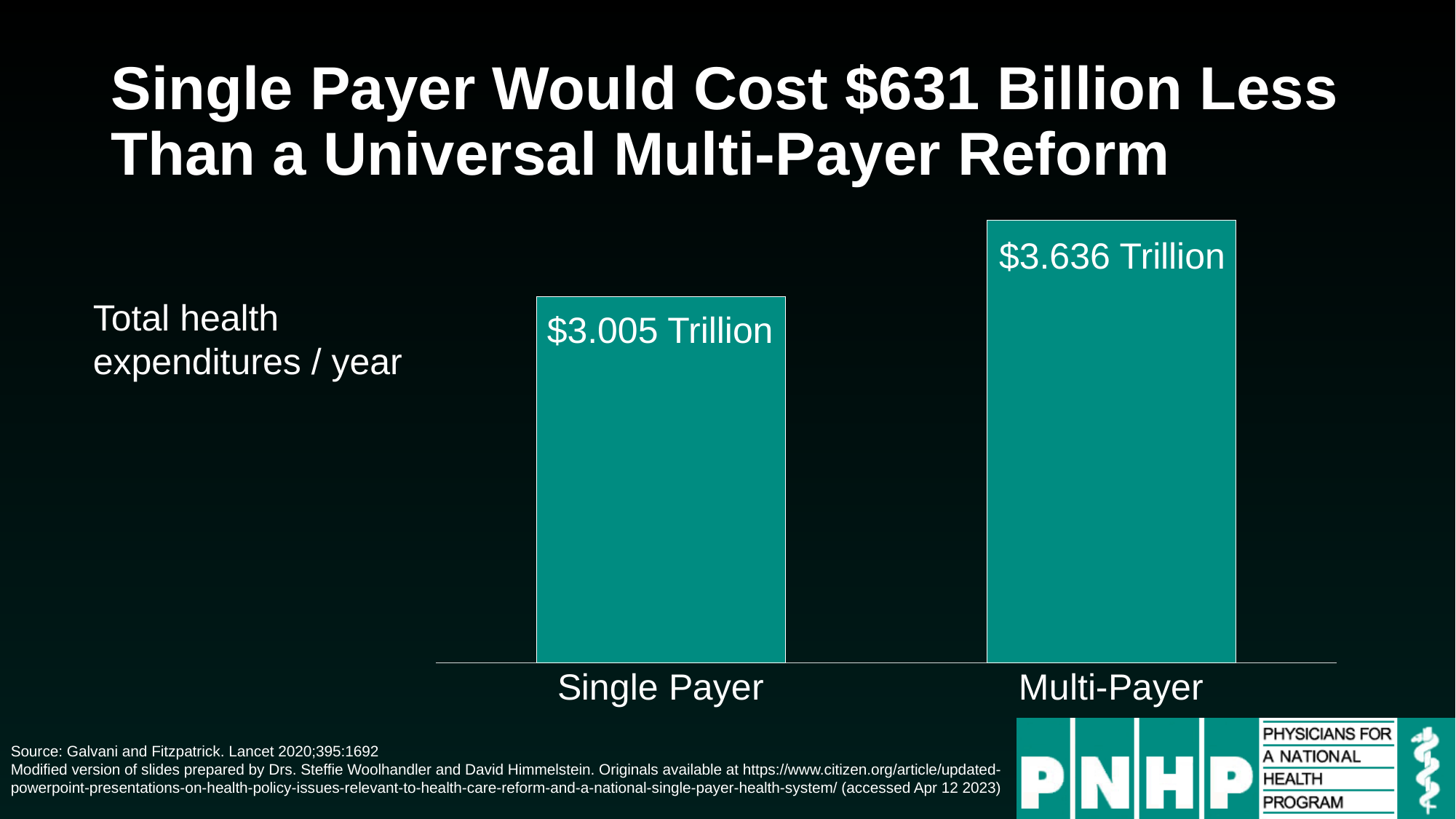
Is the value for Single Payer larger or smaller than the value for Multi-Payer? smaller What is the total health expenditure per year for Single Payer? $3.005 Trillion Which category has the lower total health expenditure per year? Single Payer Which category has the higher total health expenditure per year? Multi-Payer What is the difference in total health expenditure per year between Multi-Payer and Single Payer? $0.631 Trillion What is the title of the slide containing the chart? Single Payer Would Cost $631 Billion Less Than a Universal Multi-Payer Reform How many categories are shown in the chart? 2 What kind of chart is shown on the slide? bar chart What is the total health expenditure per year for Multi-Payer? $3.636 Trillion What quantity does the chart measure, according to the label to the left of the bars? Total health expenditures / year Do the values rise or fall from Single Payer to Multi-Payer? rise